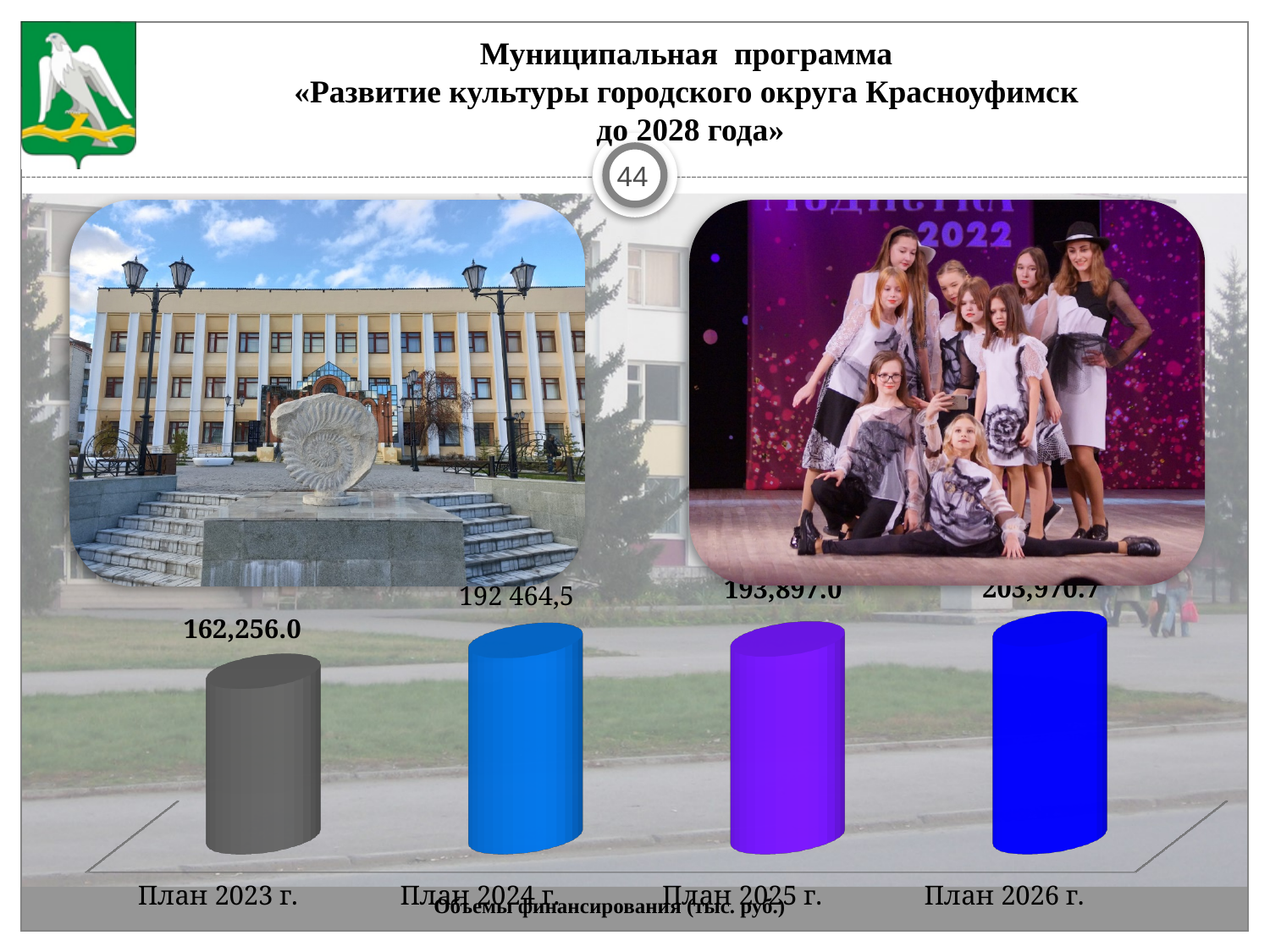
Which category has the lowest value? План 2023 г. What is the difference between the values for План 2024 г. and План 2023 г.? 30,208.5 What is the value for План 2025 г.? 193,897.0 What is the title of the chart? Объемы финансирования (тыс. руб.) How many categories are shown in the chart? 4 Which category has the highest value? План 2026 г. What is the value for План 2023 г.? 162,256.0 What is the value for План 2024 г.? 192 464,5 What kind of chart is shown on the slide? Bar chart Which is larger, the value for План 2023 г. or План 2026 г.? План 2026 г. What is the value for План 2026 г.? 203,970.7 Do the values rise or fall from План 2023 г. to План 2026 г.? Rise